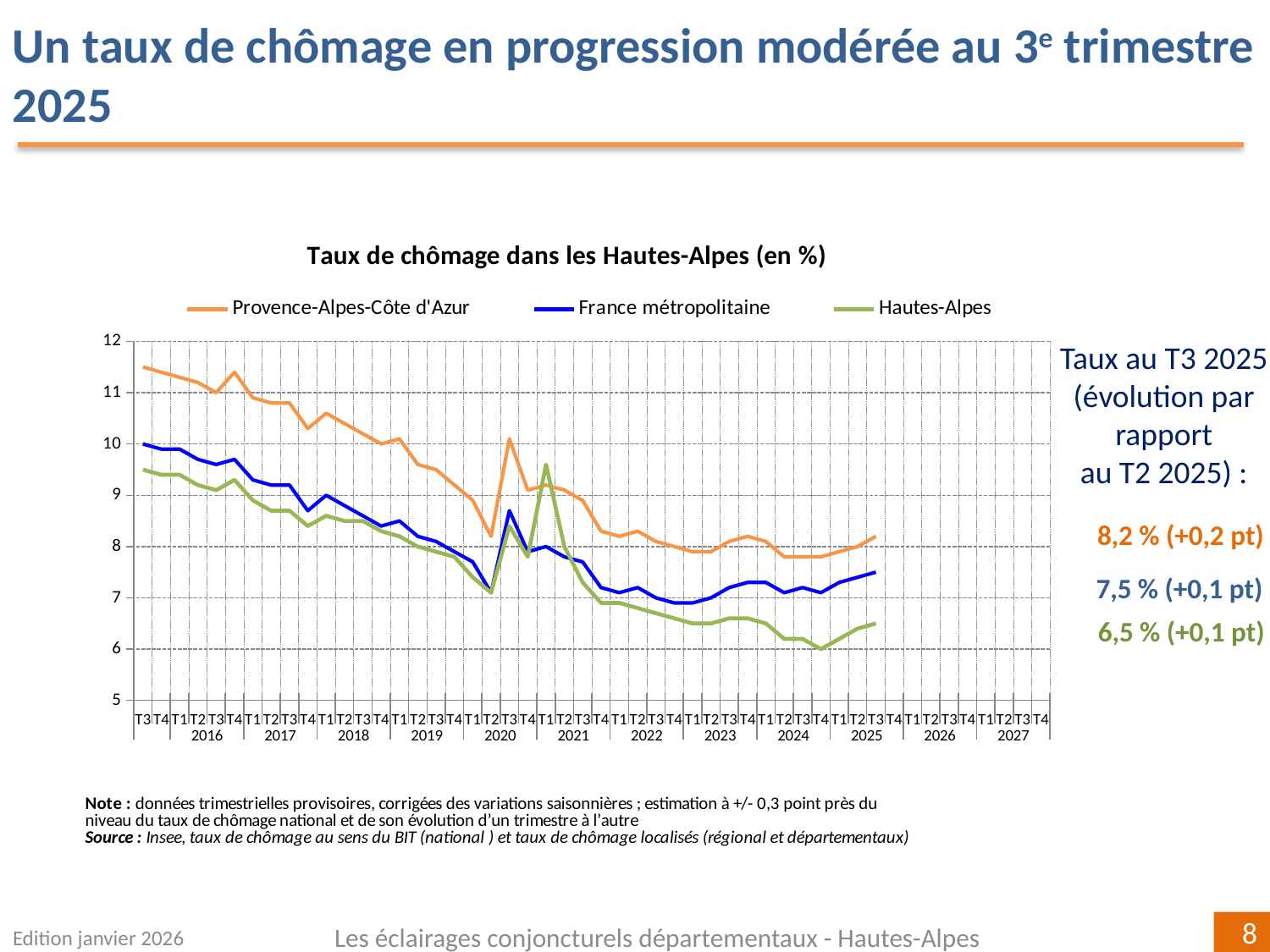
How many series does the legend list? 3 What is the unemployment rate for France métropolitaine at T3 2025? 7,5 % What is the unemployment rate for Hautes-Alpes at T3 2025? 6,5 % What is the unemployment rate for Provence-Alpes-Côte d'Azur at T3 2025? 8,2 % By how much did the Provence-Alpes-Côte d'Azur rate change between T2 2025 and T3 2025? +0,2 pt At T3 2025, which is higher: France métropolitaine or Hautes-Alpes? France métropolitaine What is the title of the chart? Taux de chômage dans les Hautes-Alpes (en %) Which series has the highest value at T3 2025? Provence-Alpes-Côte d'Azur Overall from 2015 to 2025, does the Hautes-Alpes unemployment rate rise or fall? fall Is the Hautes-Alpes value at T4 2024 greater or less than 7? less What kind of chart is shown on the slide? line chart What is the difference between the Provence-Alpes-Côte d'Azur rate and the Hautes-Alpes rate at T3 2025? 1,7 points